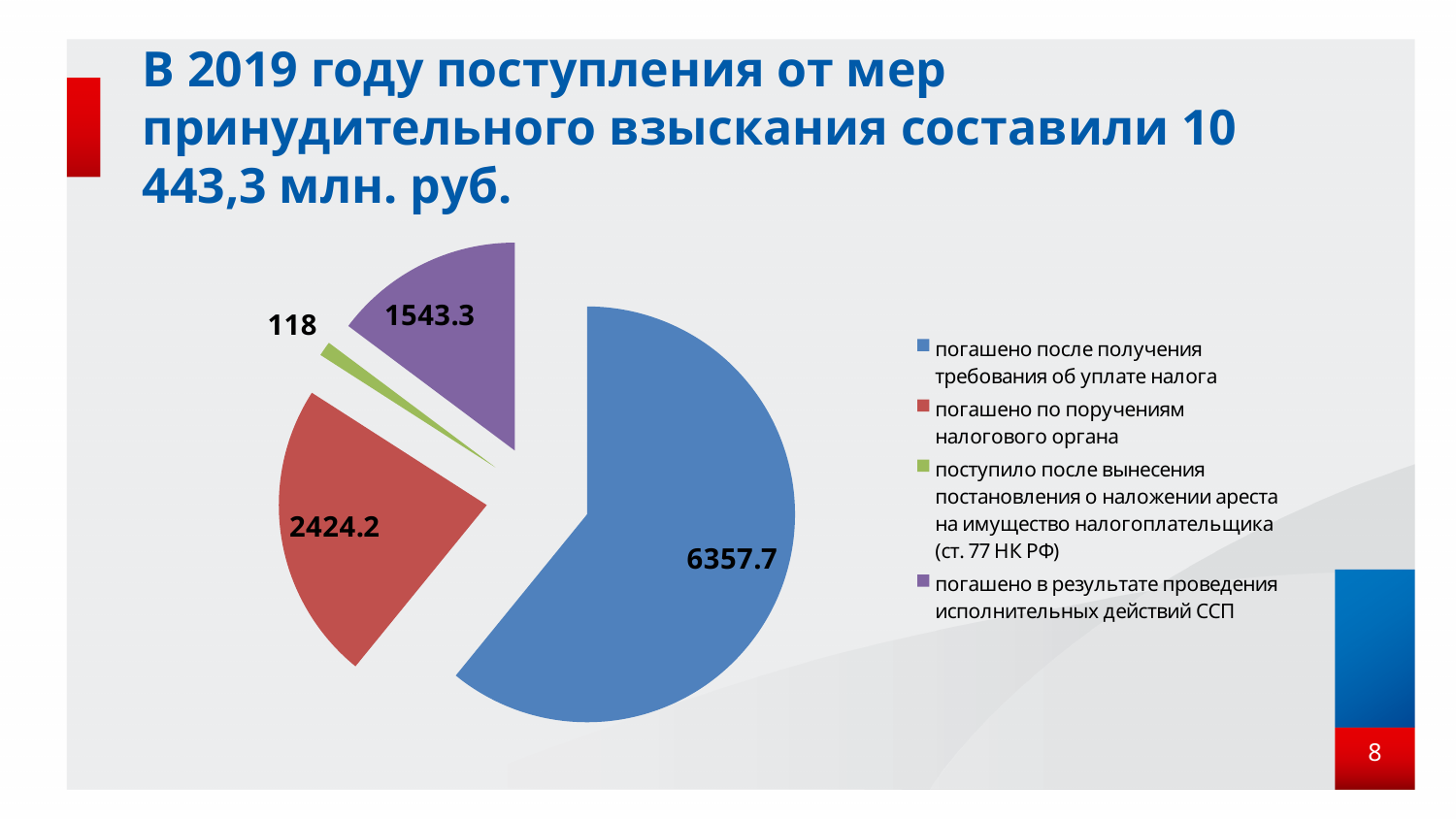
How many slices does the pie chart have? 4 What is the value for the slice "погашено после получения требования об уплате налога"? 6357.7 Which is larger: the value for "погашено в результате проведения исполнительных действий ССП" or the value for "погашено по поручениям налогового органа"? погашено по поручениям налогового органа What is the value for the slice "погашено в результате проведения исполнительных действий ССП"? 1543.3 What is the difference between the values for "погашено по поручениям налогового органа" and "погашено в результате проведения исполнительных действий ССП"? 880.9 What is the value for the slice "поступило после вынесения постановления о наложении ареста на имущество налогоплательщика (ст. 77 НК РФ)"? 118 Which category has the smallest slice of the pie? поступило после вынесения постановления о наложении ареста на имущество налогоплательщика (ст. 77 НК РФ) What kind of chart is shown on the slide? pie chart What is the value for the slice "погашено по поручениям налогового органа"? 2424.2 What is the difference between the values for "погашено после получения требования об уплате налога" and "погашено по поручениям налогового органа"? 3933.5 Which category has the largest slice of the pie? погашено после получения требования об уплате налога What colour is the slice for "погашено в результате проведения исполнительных действий ССП"? purple